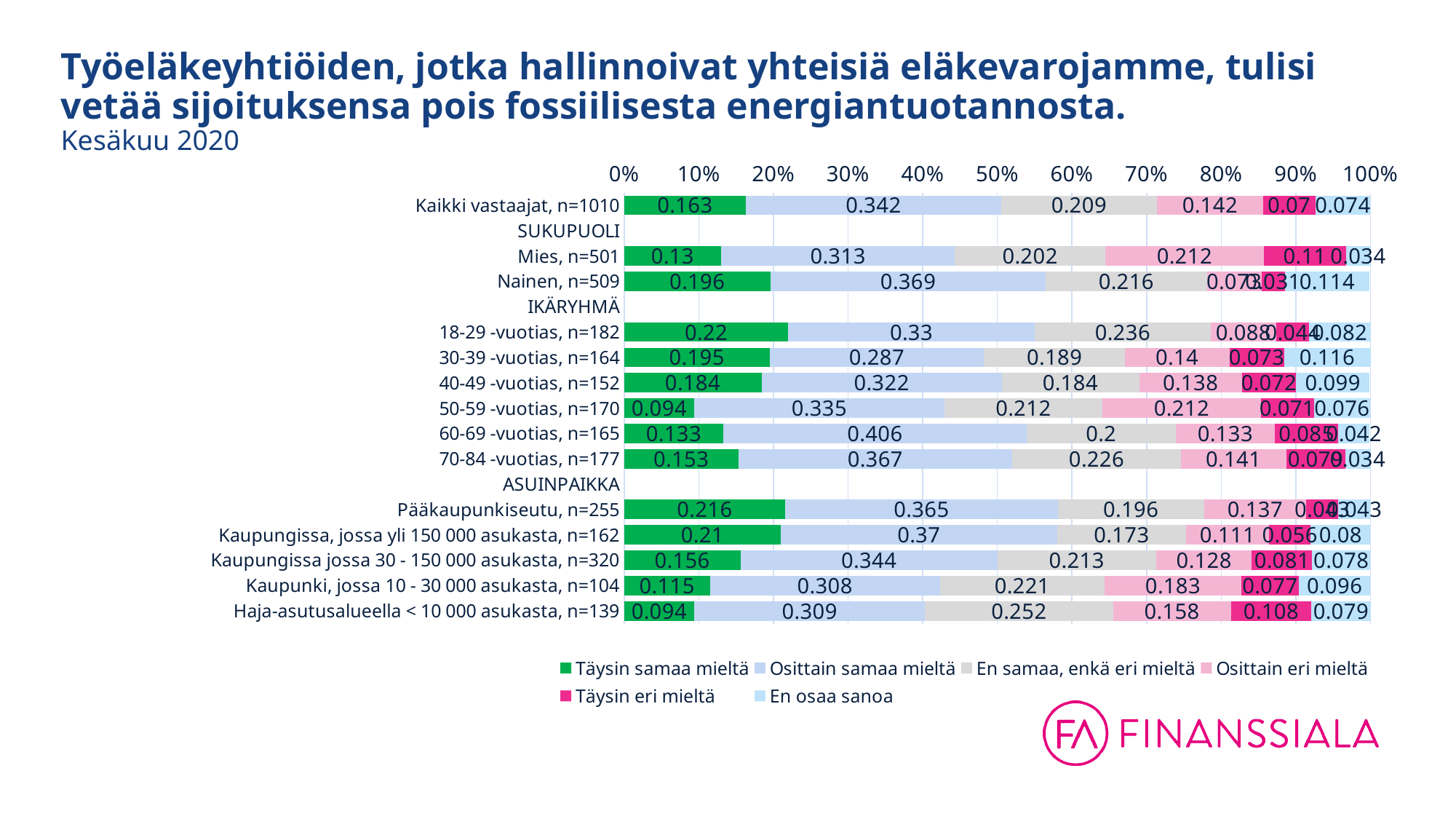
What is the value of 'En samaa, enkä eri mieltä' for 'Haja-asutusalueella < 10 000 asukasta, n=139'? 0.252 Is the 'Täysin samaa mieltä' value for 'Kaikki vastaajat, n=1010' greater or less than 20%? less What is the value of 'Täysin samaa mieltä' for 'Kaikki vastaajat, n=1010'? 0.163 What kind of chart is shown on the slide? Stacked bar chart Which category has the highest value for 'En samaa, enkä eri mieltä'? Haja-asutusalueella < 10 000 asukasta, n=139 What is the difference between 'Osittain samaa mieltä' and 'Täysin samaa mieltä' for 'Kaikki vastaajat, n=1010'? 0.179 What is the value of 'Osittain samaa mieltä' for '60-69 -vuotias, n=165'? 0.406 Which category has the highest value for 'Osittain samaa mieltä'? 60-69 -vuotias, n=165 Which is larger for 'Täysin samaa mieltä': 'Mies, n=501' or 'Nainen, n=509'? Nainen, n=509 How many series does the legend list? 6 What is the subtitle shown under the chart title? Kesäkuu 2020 What is the value of 'Osittain eri mieltä' for 'Mies, n=501'? 0.212